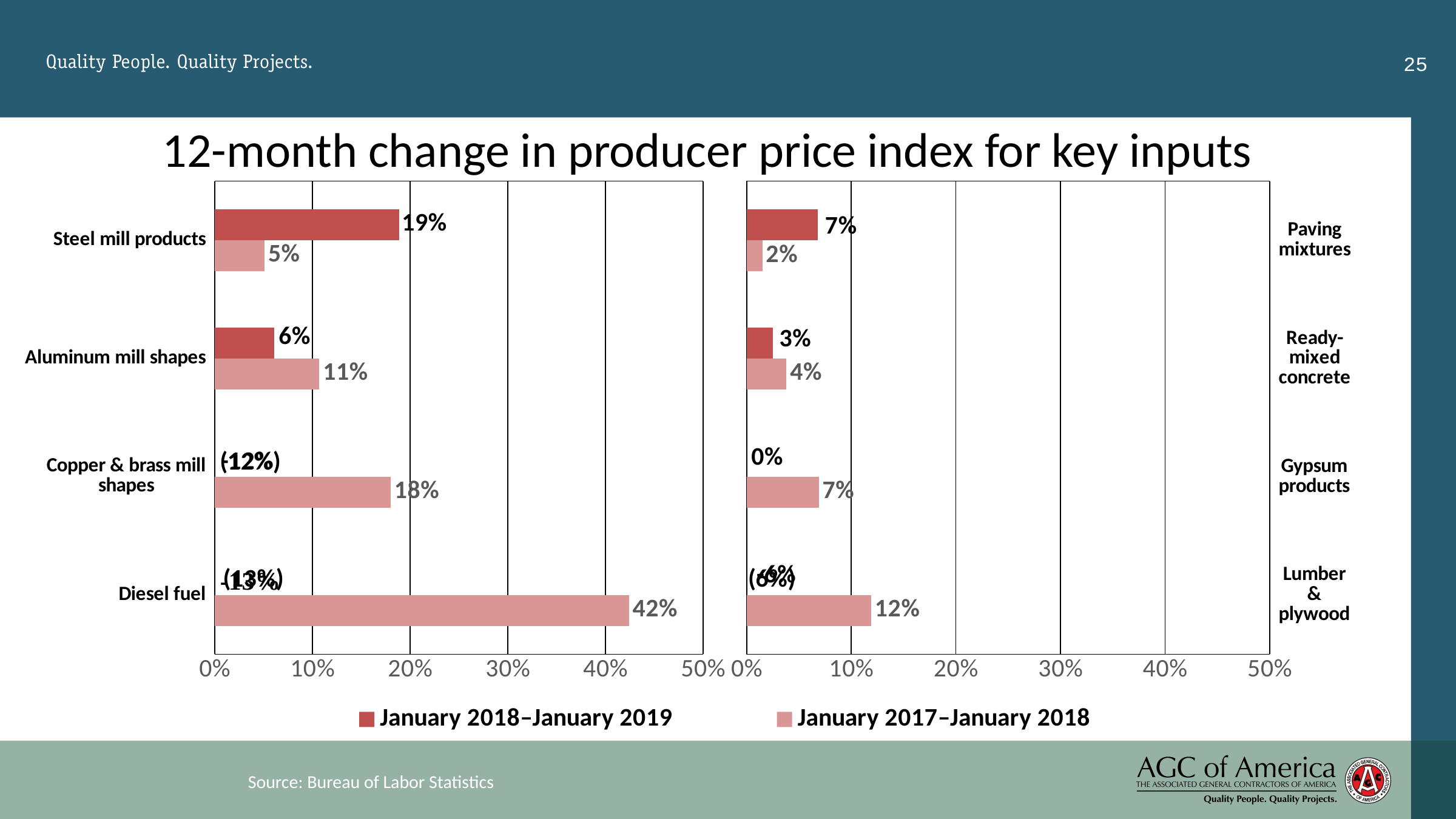
What type of chart is used on this slide? Bar chart On the left chart, what is the value for Diesel fuel in the January 2017–January 2018 series? 42% On the left chart, what is the value for Aluminum mill shapes in the January 2017–January 2018 series? 11% On the right chart, what is the value for Gypsum products in the January 2017–January 2018 series? 7% On the right chart, which is larger for Ready-mixed concrete: the January 2018–January 2019 value or the January 2017–January 2018 value? January 2017–January 2018 On the left chart, which category has the highest value in the January 2017–January 2018 series? Diesel fuel On the right chart, what is the value for Paving mixtures in the January 2018–January 2019 series? 7% On the left chart, what is the difference between the January 2018–January 2019 and January 2017–January 2018 values for Steel mill products? 14 percentage points How many series does the legend list? 2 How many categories are shown on the right chart? 4 On the left chart, what is the value for Steel mill products in the January 2018–January 2019 series? 19%